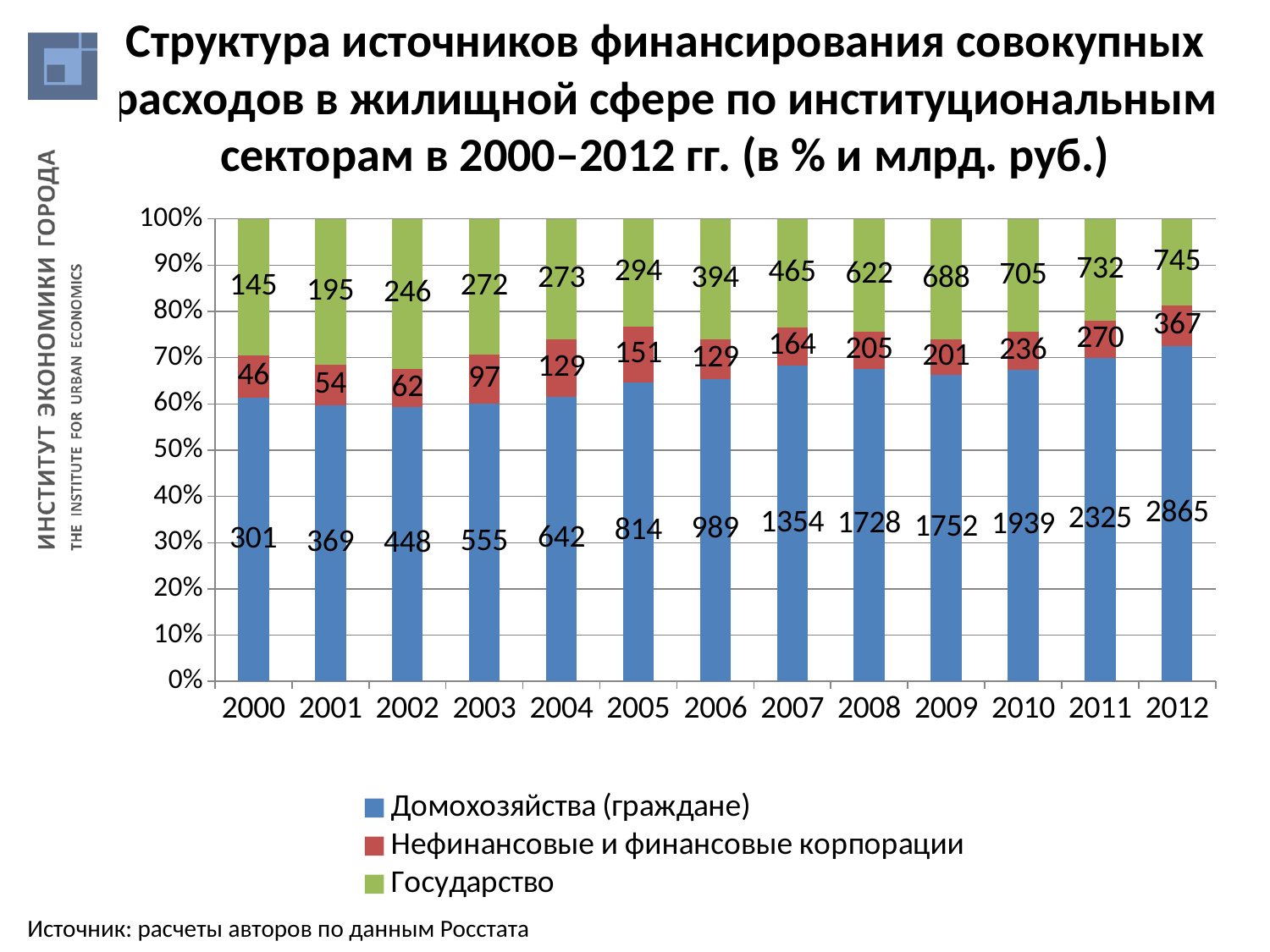
In which year is the value for Государство the lowest? 2000 How many series does the legend list? 3 What is the total of the three labelled values for 2000? 492 Is the share of Домохозяйства (граждане) in the 2012 bar greater or less than 60%? greater What kind of chart is shown on the slide? Stacked bar chart What is the difference between the Домохозяйства (граждане) values for 2012 and 2011? 540 What is the value for Домохозяйства (граждане) in 2012? 2865 Which is larger: the Государство value in 2006 or the Нефинансовые и финансовые корпорации value in 2012? Государство in 2006 In which year is the value for Домохозяйства (граждане) the highest? 2012 What is the value for Государство in 2005? 294 How many years are shown on the x axis? 13 What is the value for Нефинансовые и финансовые корпорации in 2009? 201